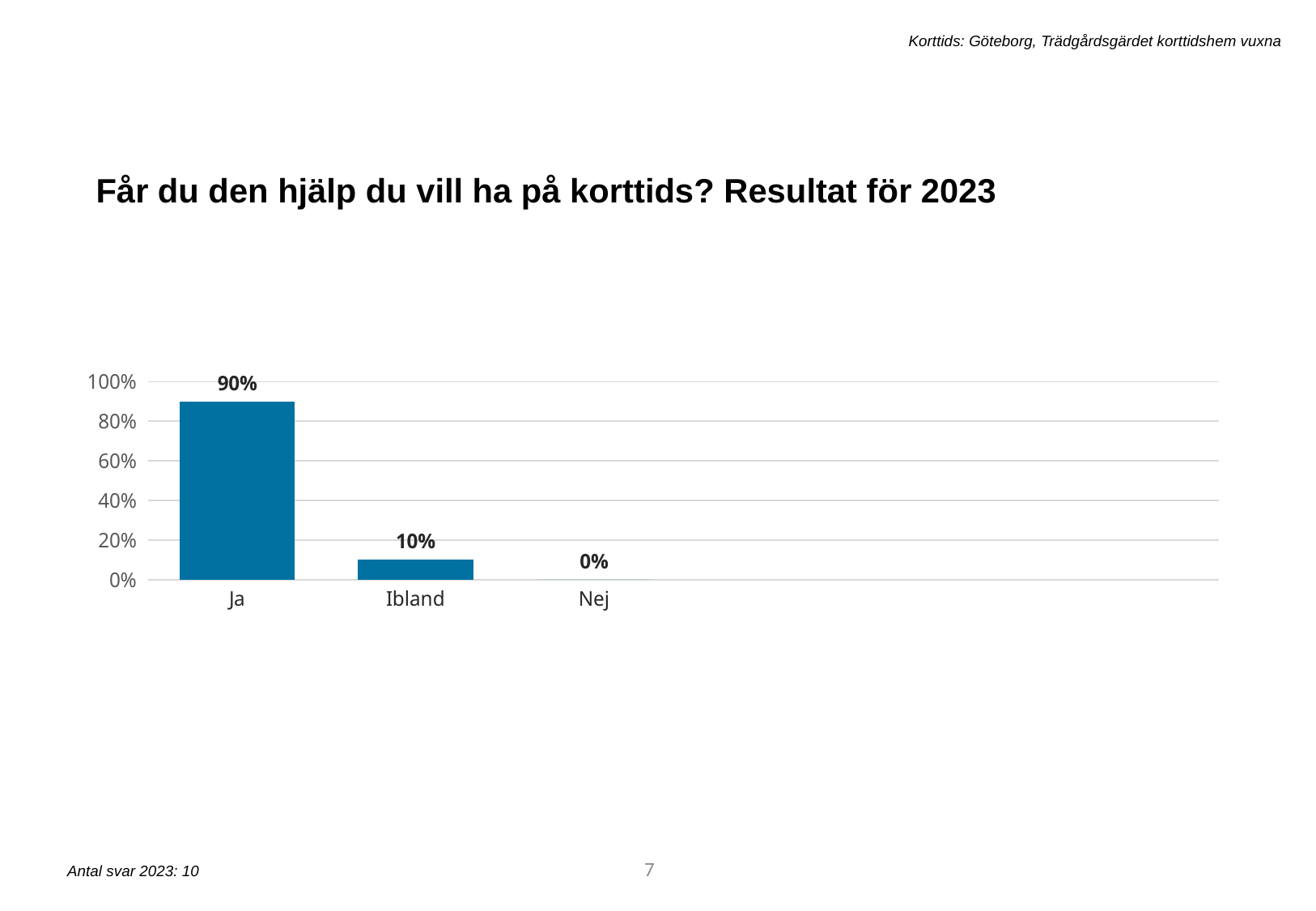
Which is larger, the value for Ibland or the value for Nej? Ibland What is the value for Ibland? 10% Is the value for Ja greater or less than 80%? greater What is the value for Nej? 0% What kind of chart is shown on the slide? bar chart What is the value for Ja? 90% Do the values rise or fall from Ja to Nej along the x axis? fall How many categories are shown on the x axis? 3 What is the difference between the values for Ja and Ibland? 80% Which category has the highest value? Ja Which category has the lowest value? Nej What is the title of the slide? Får du den hjälp du vill ha på korttids? Resultat för 2023